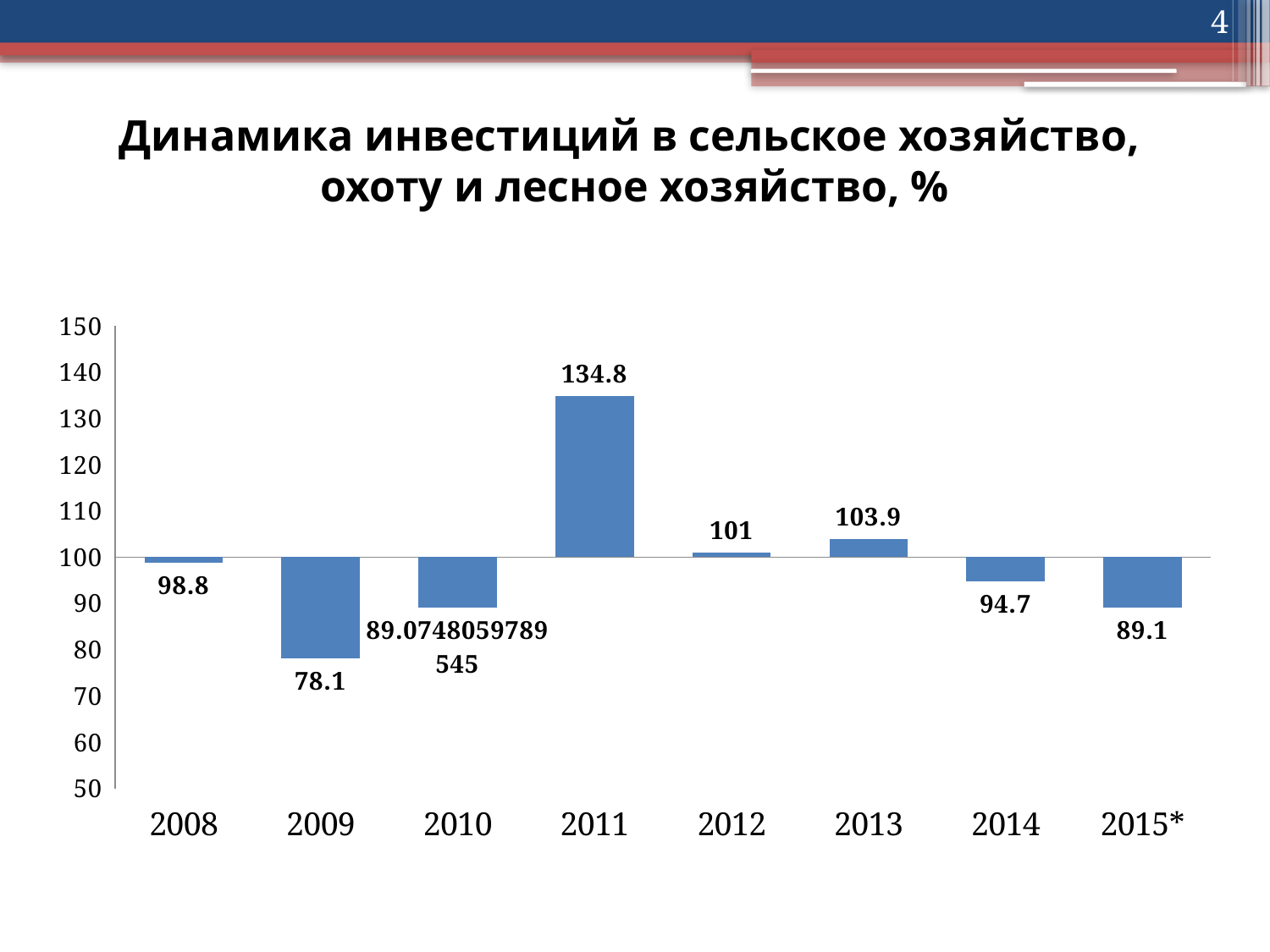
Which year has the lowest value? 2009 How many years are shown on the x axis? 8 What is the value for 2013? 103.9 Is the value for 2010 greater or less than 100? less Which year has the highest value? 2011 What is the value for 2009? 78.1 What is the difference between the values for 2011 and 2012? 33.8 What is the title of the slide? Динамика инвестиций в сельское хозяйство, охоту и лесное хозяйство, % Which is larger, the value for 2014 or the value for 2015*? 2014 What is the value for 2015*? 89.1 What is the value for 2011? 134.8 What kind of chart is shown on the slide? bar chart